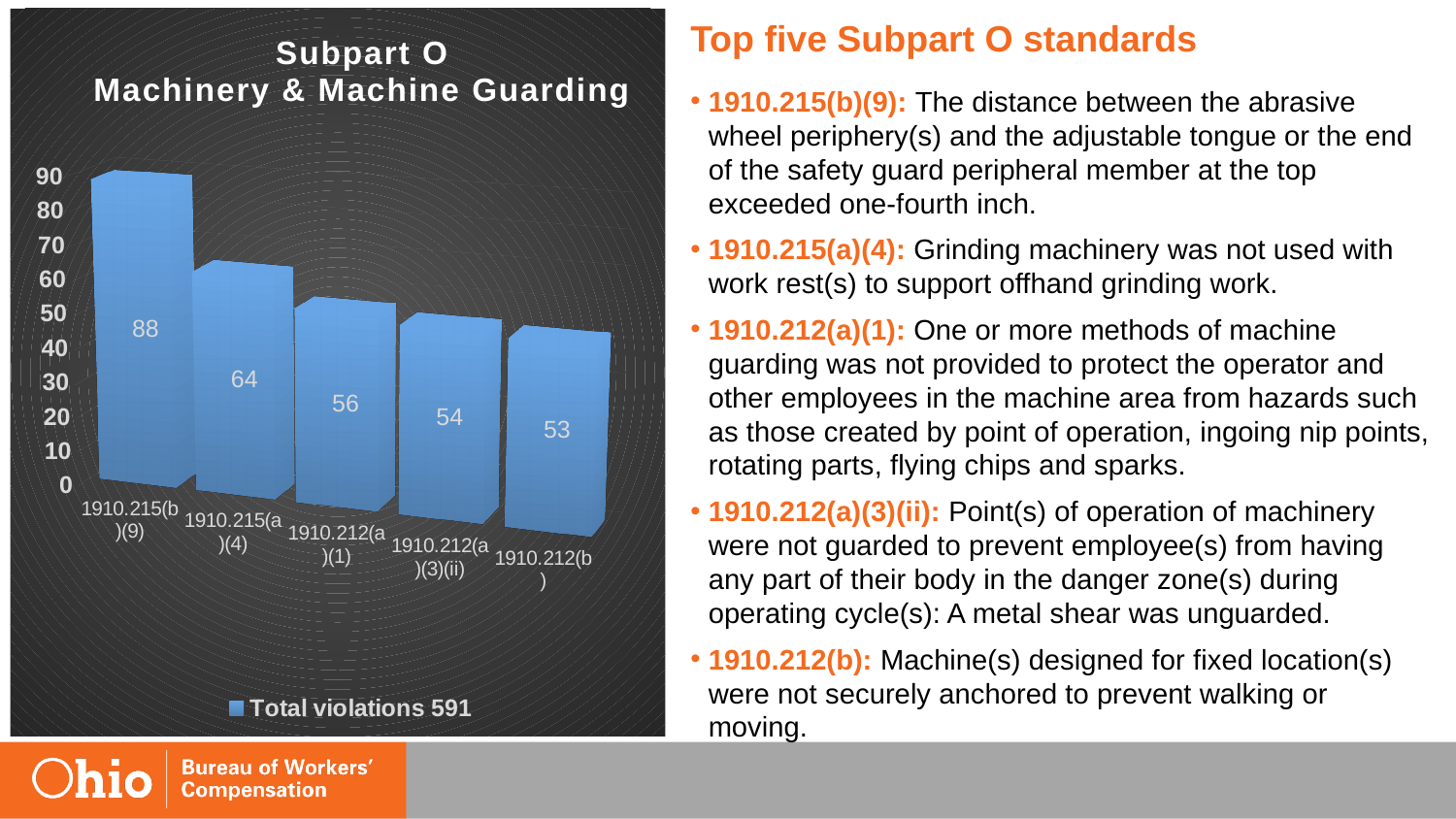
How many categories are shown in the chart? 5 What is the value for 1910.215(b)(9)? 88 What is the difference between the values for 1910.215(b)(9) and 1910.215(a)(4)? 24 Which category has the highest value? 1910.215(b)(9) What is the difference between the values for 1910.212(a)(3)(ii) and 1910.212(b)? 1 Is the value for 1910.215(a)(4) greater or less than 60? greater What does the legend entry of the chart say? Total violations 591 What is the value for 1910.212(b)? 53 What is the value for 1910.212(a)(1)? 56 What kind of chart is shown on the slide? bar chart Which category has the lowest value? 1910.212(b) Which is larger, the value for 1910.215(a)(4) or the value for 1910.212(a)(1)? 1910.215(a)(4)